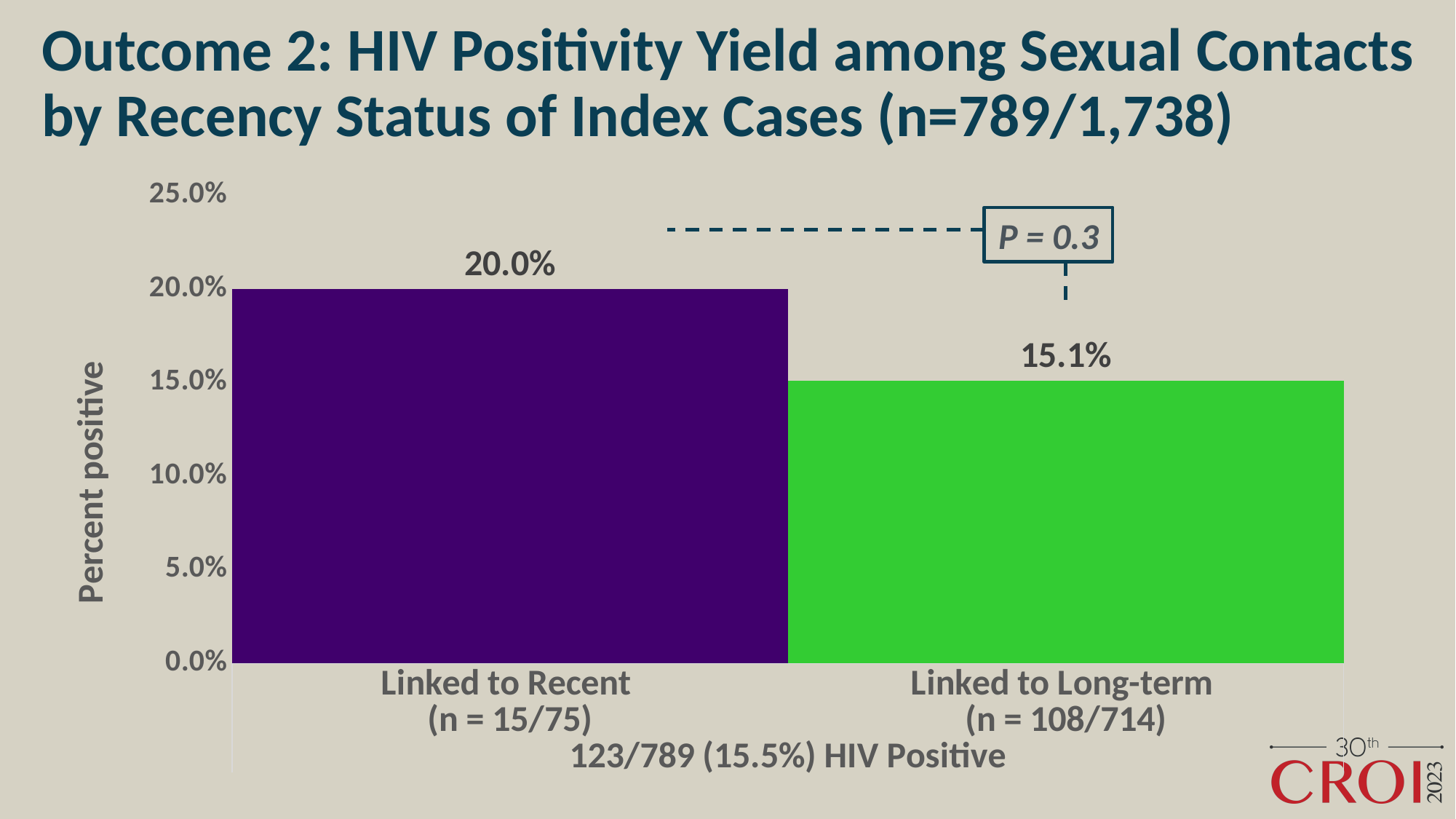
Which group has the higher percent positive? Linked to Recent How many categories are shown on the x axis? 2 Which group has the lower percent positive? Linked to Long-term What is the difference in percent positive between the Linked to Recent and Linked to Long-term groups? 4.9% What kind of chart is shown on the slide? Bar chart What is the sample size (n) shown for the Linked to Long-term group? n = 108/714 What is the label of the y axis? Percent positive What is the percent positive for the Linked to Long-term group? 15.1% What is the percent positive for the Linked to Recent group? 20.0% What P value is shown on the chart? P = 0.3 Is the percent positive higher for Linked to Recent or Linked to Long-term? Linked to Recent Is the value for Linked to Long-term greater or less than 20.0%? less